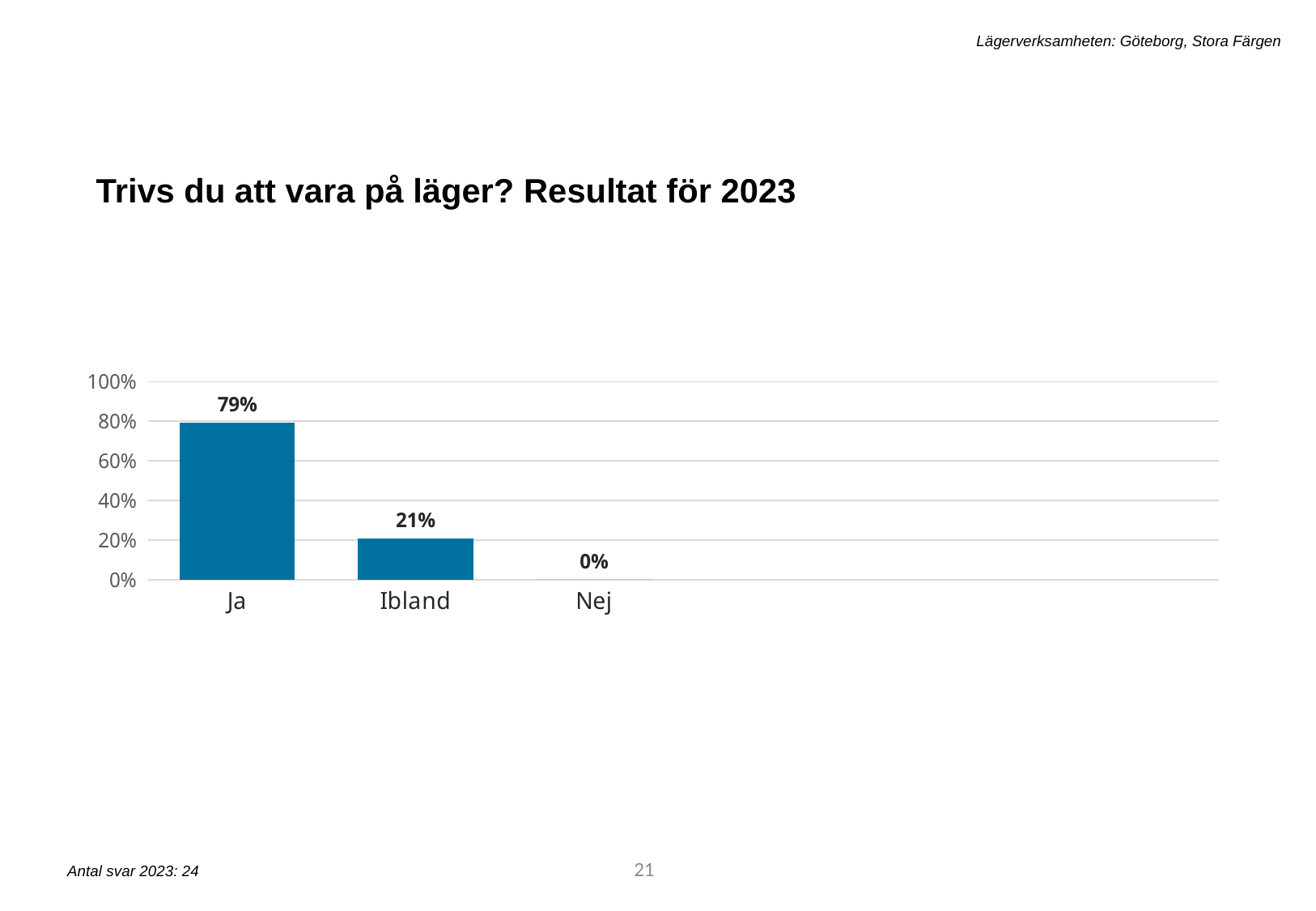
What kind of chart is shown on the slide? bar chart How many categories are shown on the x axis? 3 What is the value for Ja? 79% What is the value for Ibland? 21% Which is larger, the value for Ibland or the value for Nej? Ibland Is the value for Ja greater or less than 60%? greater Which category has the highest value? Ja Which category has the lowest value? Nej What is the value for Nej? 0% What is the difference between the values for Ja and Ibland? 58% What is the title of the slide above the chart? Trivs du att vara på läger? Resultat för 2023 Is the value for Ibland greater or less than 40%? less